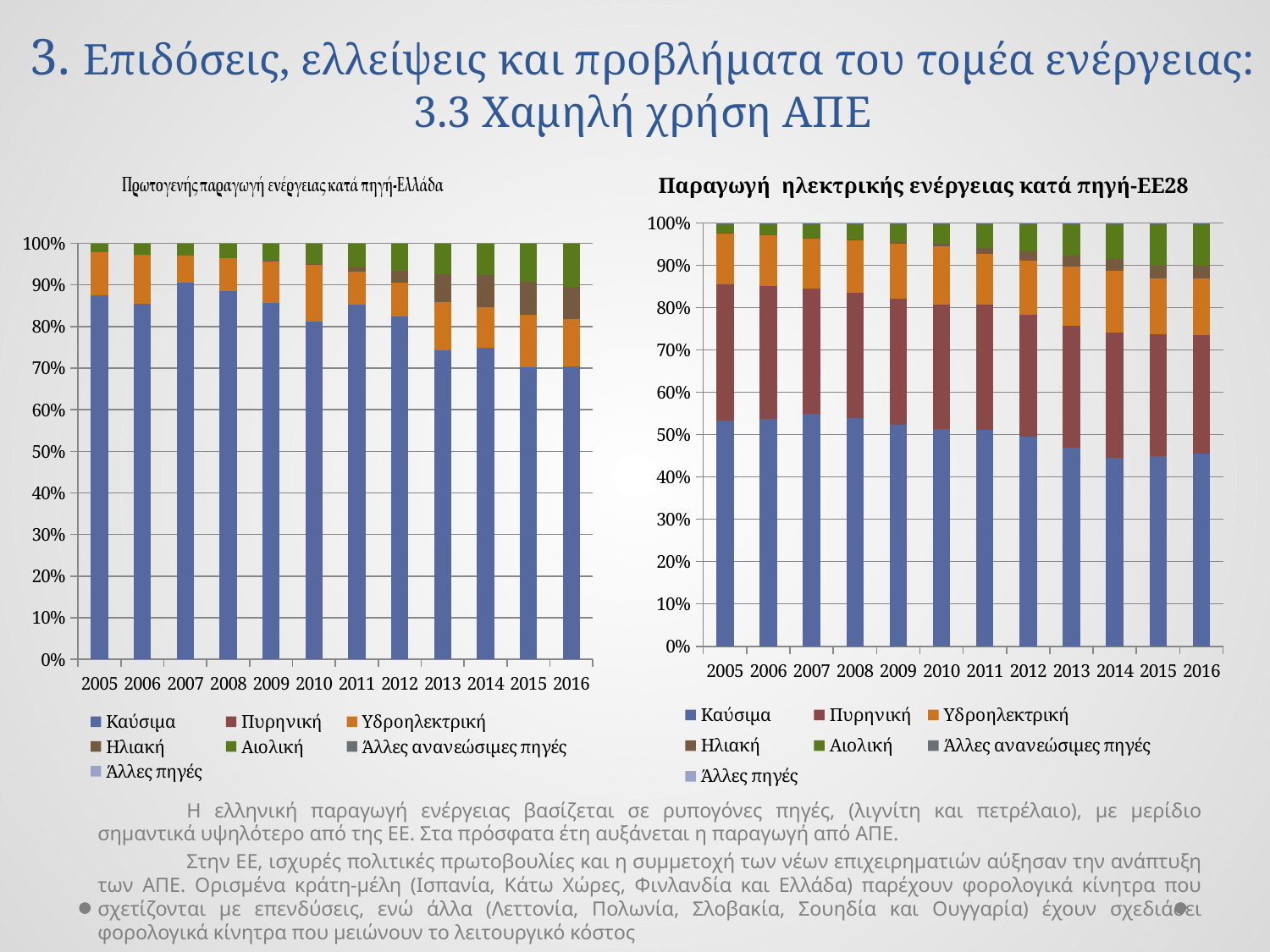
In the left chart 'Πρωτογενής παραγωγή ενέργειας κατά πηγή-Ελλάδα', does the Αιολική share rise or fall from 2005 to 2016? rise In the left chart 'Πρωτογενής παραγωγή ενέργειας κατά πηγή-Ελλάδα', which is larger, the Καύσιμα share in 2007 or in 2016? 2007 What kind of chart is the left chart titled 'Πρωτογενής παραγωγή ενέργειας κατά πηγή-Ελλάδα'? Stacked bar chart In the right chart 'Παραγωγή ηλεκτρικής ενέργειας κατά πηγή-ΕΕ28', does the Καύσιμα share rise or fall from 2005 to 2016? fall In the left chart 'Πρωτογενής παραγωγή ενέργειας κατά πηγή-Ελλάδα', is the Καύσιμα share for 2016 greater or less than 80%? less What is the title of the right chart on the slide? Παραγωγή ηλεκτρικής ενέργειας κατά πηγή-ΕΕ28 In the right chart 'Παραγωγή ηλεκτρικής ενέργειας κατά πηγή-ΕΕ28', what is the total of the stacked bar for 2010? 100% In the left chart 'Πρωτογενής παραγωγή ενέργειας κατά πηγή-Ελλάδα', is the Καύσιμα share for 2005 greater or less than 80%? greater In the right chart 'Παραγωγή ηλεκτρικής ενέργειας κατά πηγή-ΕΕ28', is the Καύσιμα share for 2016 greater or less than 50%? less In the right chart 'Παραγωγή ηλεκτρικής ενέργειας κατά πηγή-ΕΕ28', how many years are shown on the x axis? 12 How many series does the legend of the left chart 'Πρωτογενής παραγωγή ενέργειας κατά πηγή-Ελλάδα' list? 7 In the right chart 'Παραγωγή ηλεκτρικής ενέργειας κατά πηγή-ΕΕ28', which is larger, the Καύσιμα share in 2007 or in 2016? 2007